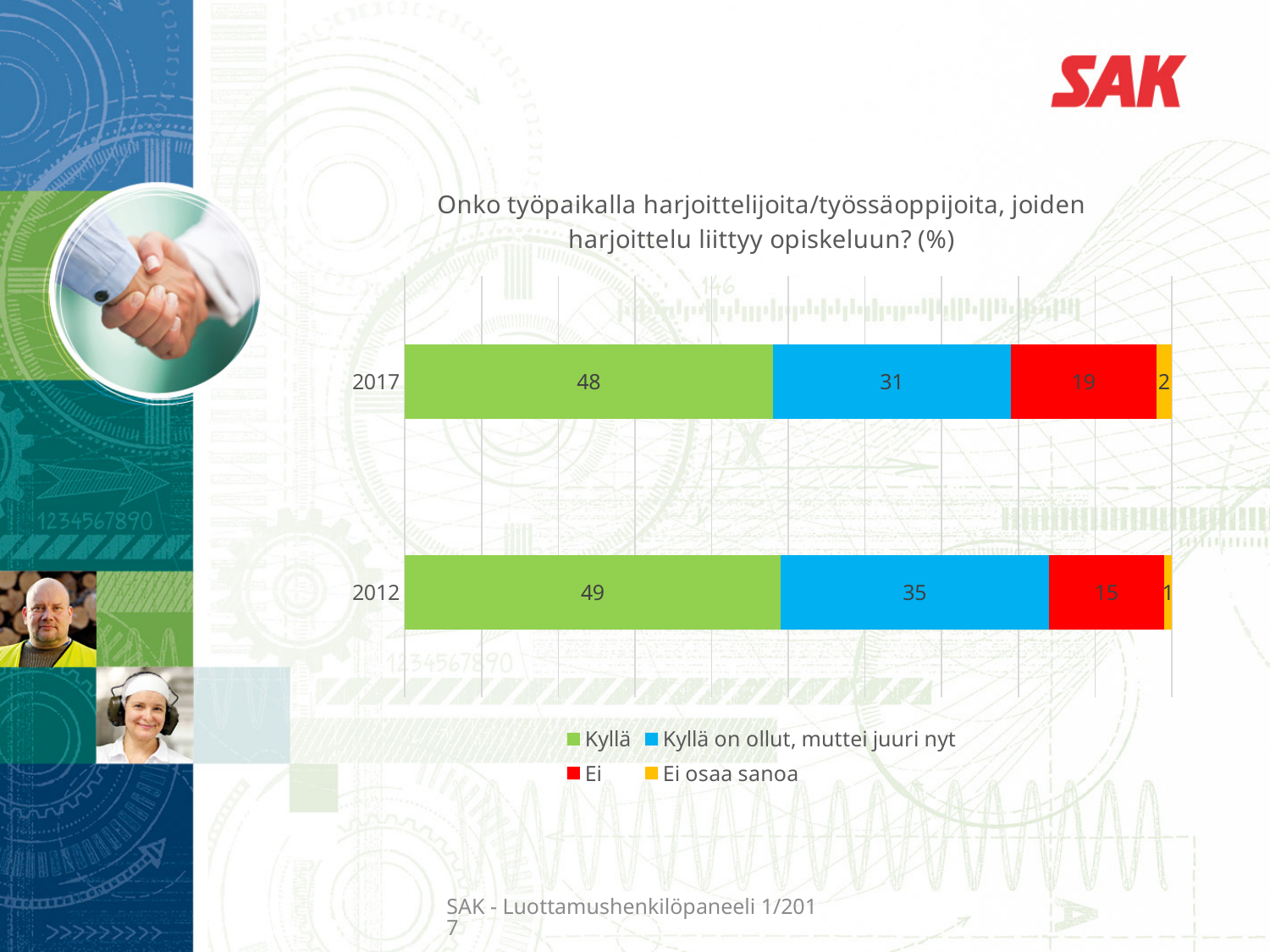
What is the value for "Kyllä on ollut, muttei juuri nyt" in 2012? 35 What is the value for "Kyllä" in 2017? 48 How many series does the legend list? 4 Which year has the higher value for "Ei"? 2017 What is the difference between the "Kyllä on ollut, muttei juuri nyt" values for 2012 and 2017? 4 What is the total of the stacked bar for 2017? 100 Which colour represents "Ei" in the chart? red Which series has the lowest value in 2012? Ei osaa sanoa What kind of chart is shown on the slide? stacked bar chart How many categories (years) are shown on the chart? 2 What is the value for "Ei osaa sanoa" in 2012? 1 What is the value for "Ei" in 2017? 19